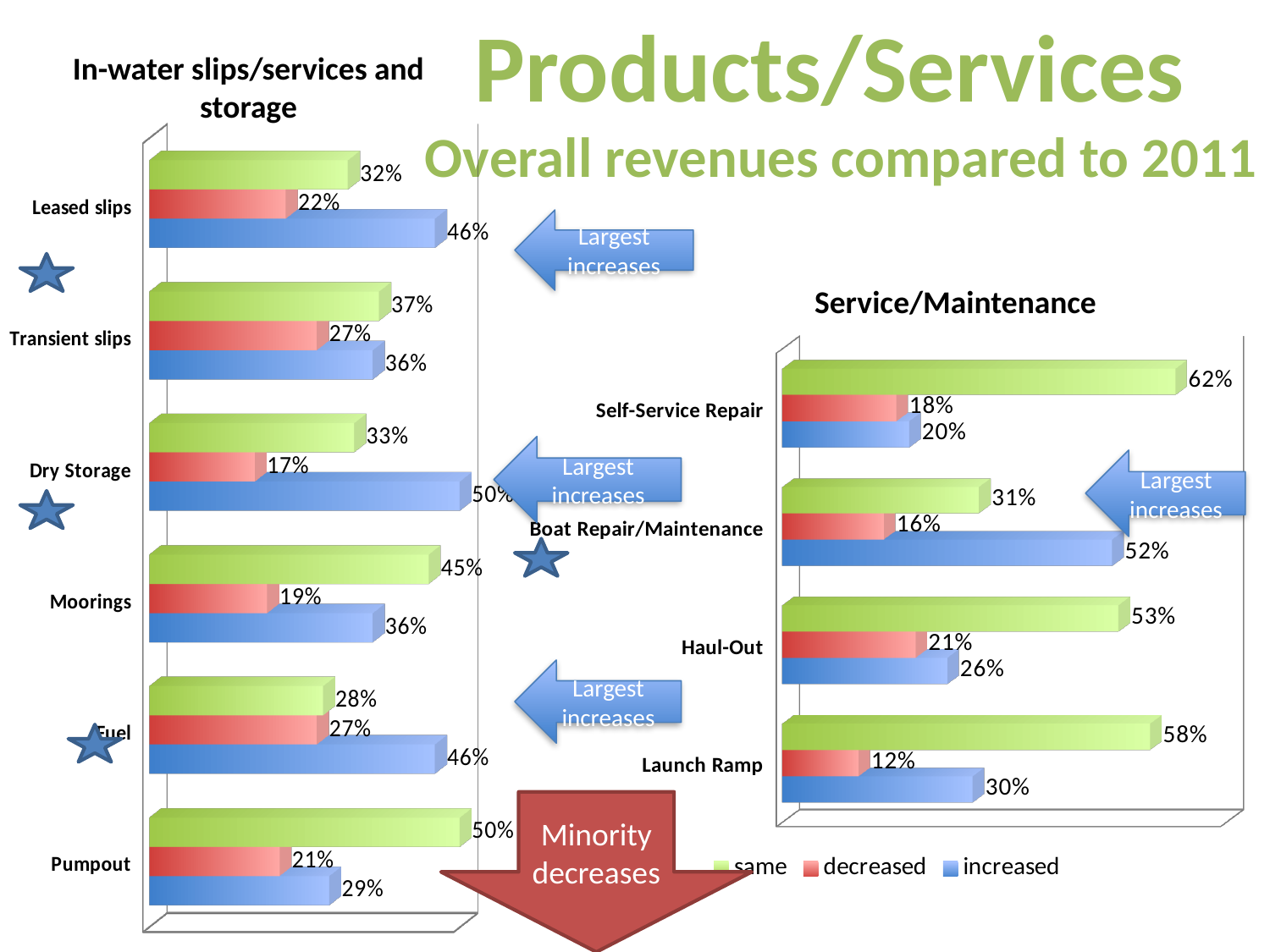
In the Service/Maintenance chart, which category has the lowest 'decreased' value? Launch Ramp In the In-water slips/services and storage chart, what percentage of respondents reported increased revenue for Leased slips? 46% In the In-water slips/services and storage chart, what is the difference between the 'increased' and 'decreased' values for Fuel? 19% In the In-water slips/services and storage chart, which category has the highest 'increased' value? Dry Storage What type of chart is the Service/Maintenance chart? Bar chart How many categories are shown in the In-water slips/services and storage chart? 6 In the In-water slips/services and storage chart, what is the 'decreased' value for Dry Storage? 17% In the Service/Maintenance chart, which is larger for Haul-Out: the 'same' value or the 'increased' value? same How many series does the legend list? 3 In the Service/Maintenance chart, what is the 'same' value for Self-Service Repair? 62% How many categories are shown in the Service/Maintenance chart? 4 In the Service/Maintenance chart, what is the 'increased' value for Boat Repair/Maintenance? 52%